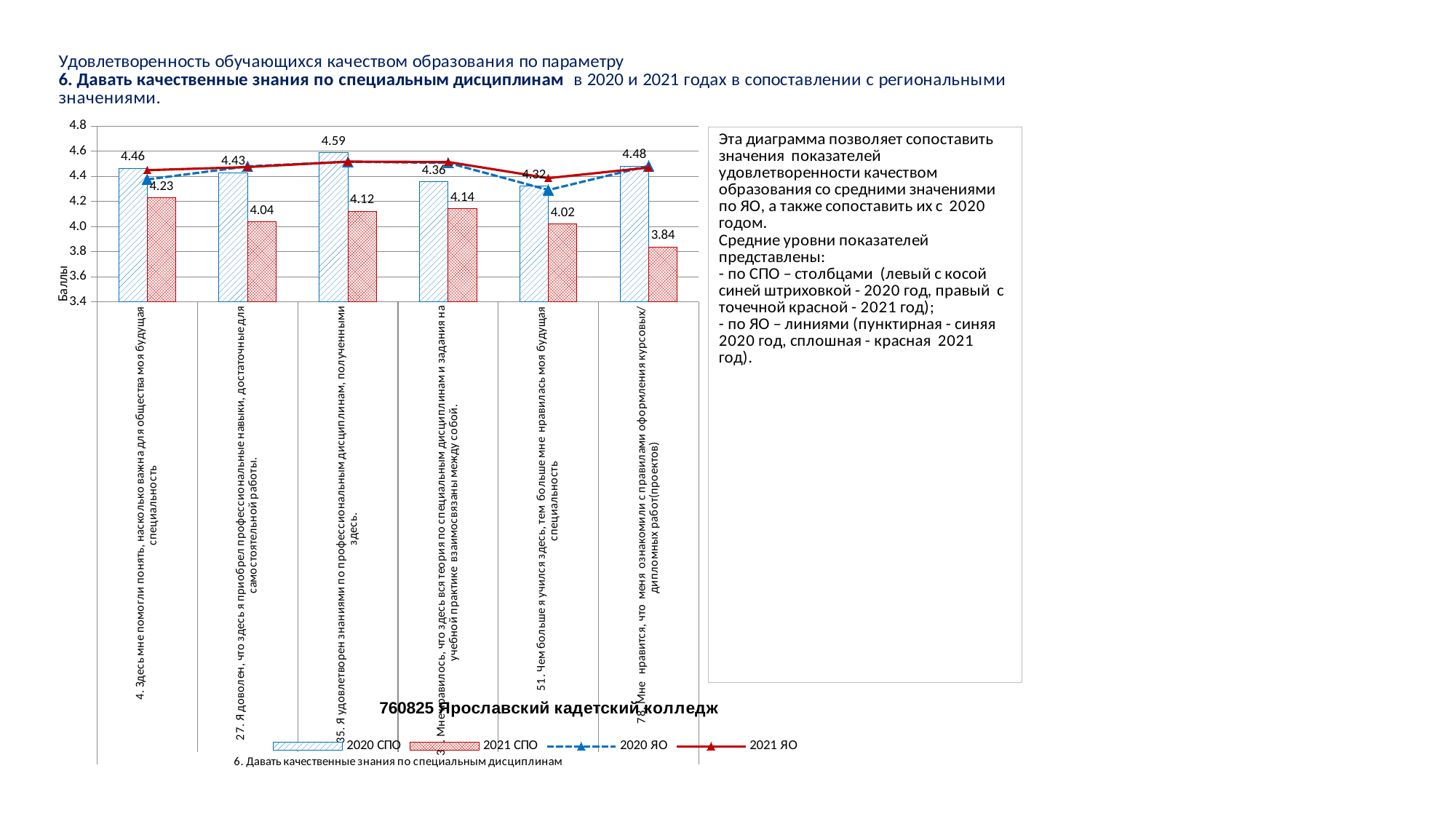
What is the title of the vertical axis of the chart? Баллы Which category has the highest 2020 СПО value? 35. Я удовлетворен знаниями по профессиональным дисциплинам, полученным здесь. What is the 2021 СПО value for the category "4. Здесь мне помогли понять, насколько важна для общества моя будущая специальность"? 4.23 What is the difference between the 2020 СПО and 2021 СПО values for the category "4. Здесь мне помогли понять, насколько важна для общества моя будущая специальность"? 0.23 Is the 2021 ЯО value for the category "35. Я удовлетворен знаниями по профессиональным дисциплинам, полученным здесь." greater or less than 4.4? greater What is the lowest 2021 СПО value shown on the chart? 3.84 How many categories are shown on the x axis of the chart? 6 What is the difference between the 2020 СПО and 2021 СПО values for the category "27. Я доволен, что здесь я приобрел профессиональные навыки, достаточные для самостоятельной работы."? 0.39 Which has the larger 2021 СПО value: category 35 (знаниями по профессиональным дисциплинам) or category 27 (профессиональные навыки)? Category 35 How many series does the chart legend list? 4 What is the 2020 СПО value for the category "35. Я удовлетворен знаниями по профессиональным дисциплинам, полученным здесь."? 4.59 What is the 2021 СПО value for the category "51. Чем больше я учился здесь, тем больше мне нравилась моя будущая специальность"? 4.02